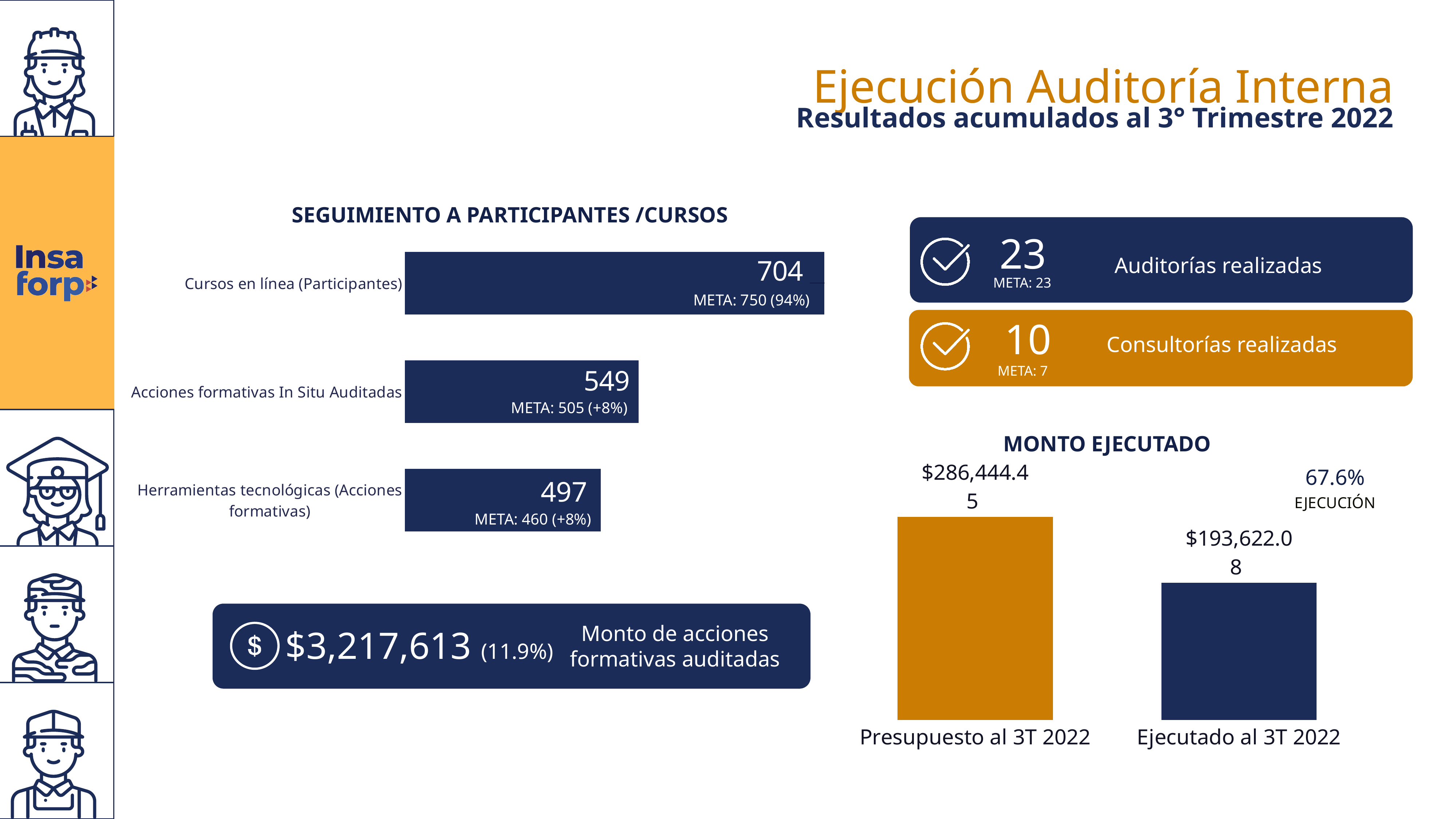
What kind of chart is 'SEGUIMIENTO A PARTICIPANTES /CURSOS'? Bar chart In the 'SEGUIMIENTO A PARTICIPANTES /CURSOS' chart, what is the value for Herramientas tecnológicas (Acciones formativas)? 497 In the 'MONTO EJECUTADO' chart, what colour is the bar for Presupuesto al 3T 2022? Orange In the 'SEGUIMIENTO A PARTICIPANTES /CURSOS' chart, how many categories are shown? 3 In the 'SEGUIMIENTO A PARTICIPANTES /CURSOS' chart, what is the value for Acciones formativas In Situ Auditadas? 549 In the 'SEGUIMIENTO A PARTICIPANTES /CURSOS' chart, what is the difference between the values for Cursos en línea (Participantes) and Acciones formativas In Situ Auditadas? 155 In the 'MONTO EJECUTADO' chart, which is larger, Presupuesto al 3T 2022 or Ejecutado al 3T 2022? Presupuesto al 3T 2022 In the 'SEGUIMIENTO A PARTICIPANTES /CURSOS' chart, what is the value for Cursos en línea (Participantes)? 704 In the 'MONTO EJECUTADO' chart, what is the value for Presupuesto al 3T 2022? $286,444.45 In the 'SEGUIMIENTO A PARTICIPANTES /CURSOS' chart, which category has the highest value? Cursos en línea (Participantes) In the 'SEGUIMIENTO A PARTICIPANTES /CURSOS' chart, which category has the lowest value? Herramientas tecnológicas (Acciones formativas) In the 'MONTO EJECUTADO' chart, what is the value for Ejecutado al 3T 2022? $193,622.08